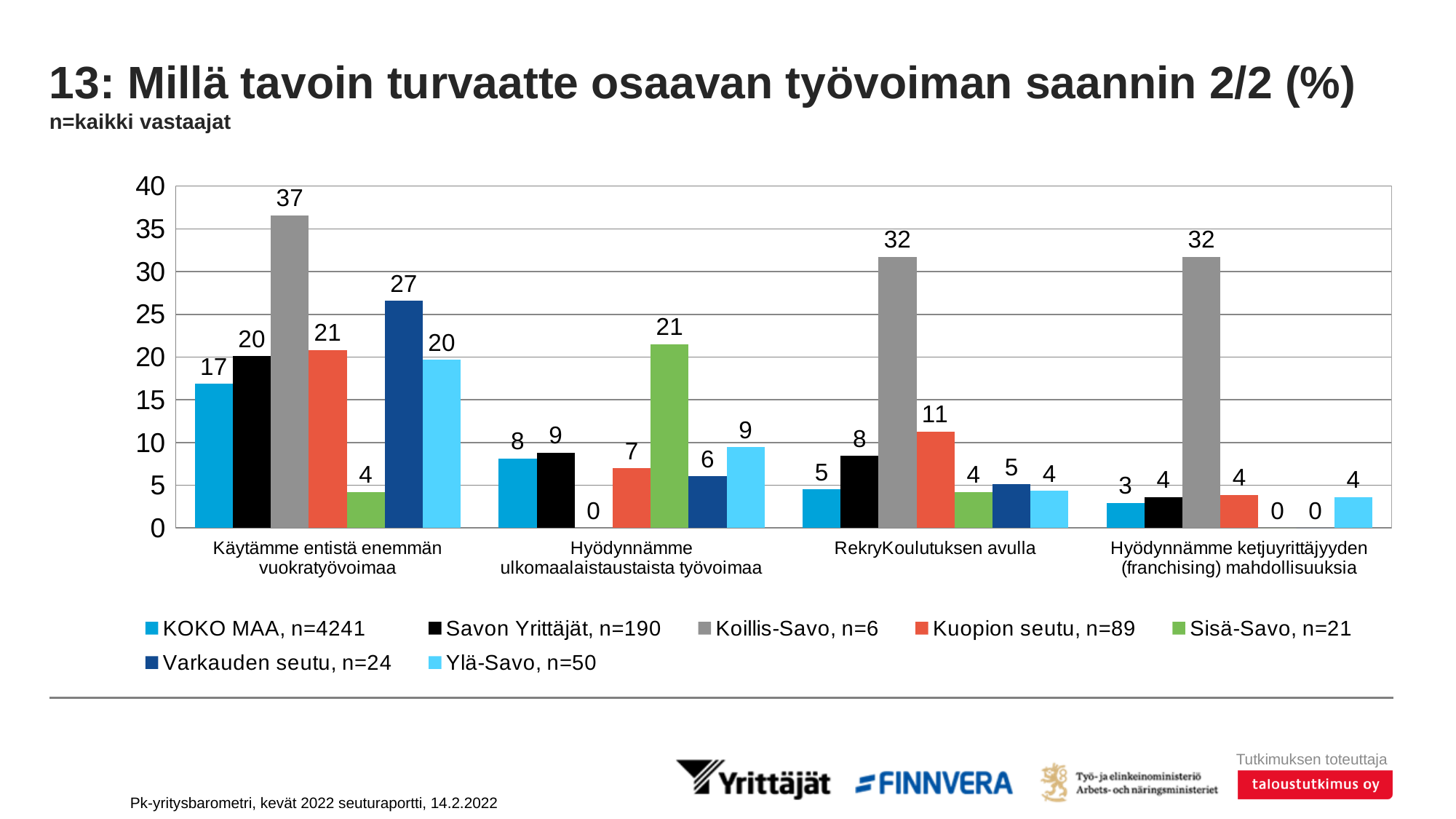
Which series has the highest value in the category "Käytämme entistä enemmän vuokratyövoimaa"? Koillis-Savo, n=6 What is the value for Koillis-Savo, n=6 in the category "Käytämme entistä enemmän vuokratyövoimaa"? 37 Which series has the lowest value in the category "Hyödynnämme ulkomaalaistaustaista työvoimaa"? Koillis-Savo, n=6 What is the value for Sisä-Savo, n=21 in the category "Hyödynnämme ulkomaalaistaustaista työvoimaa"? 21 How many series does the legend list? 7 What is the difference between the Varkauden seutu, n=24 value and the KOKO MAA, n=4241 value in the category "Käytämme entistä enemmän vuokratyövoimaa"? 10 What is the value for Kuopion seutu, n=89 in the category "RekryKoulutuksen avulla"? 11 What kind of chart is shown on the slide? Bar chart How many categories are shown on the x axis of the chart? 4 In the category "RekryKoulutuksen avulla", which is larger: the value for Savon Yrittäjät, n=190 or the value for KOKO MAA, n=4241? Savon Yrittäjät, n=190 What colour are the bars for Koillis-Savo, n=6? Grey What is the value for KOKO MAA, n=4241 in the category "Hyödynnämme ketjuyrittäjyyden (franchising) mahdollisuuksia"? 3